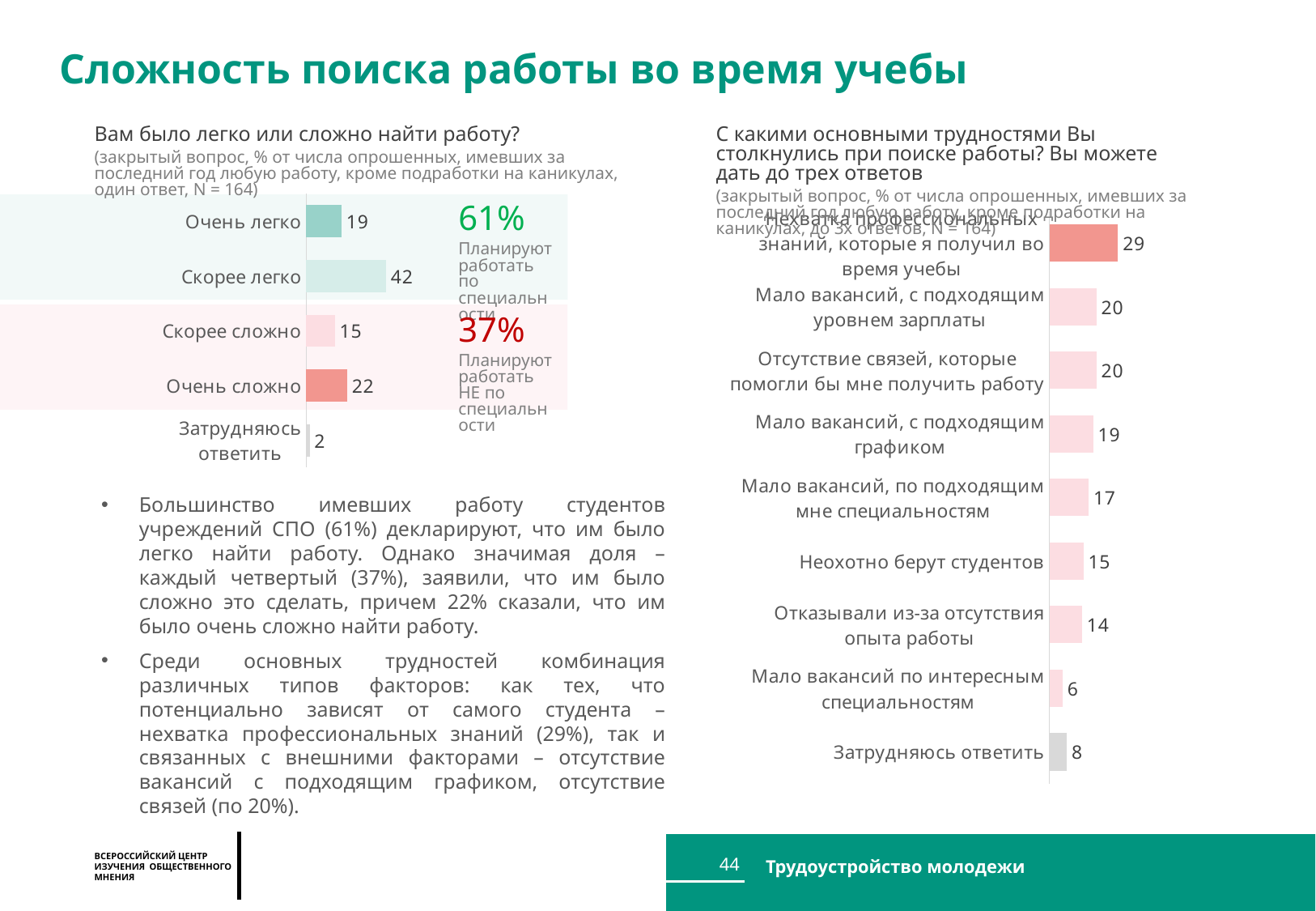
In the right chart about difficulties in finding work, which category has the lowest value? Мало вакансий по интересным специальностям In the left chart "Вам было легко или сложно найти работу?", what is the value for "Скорее легко"? 42 In the right chart about difficulties in finding work, which category has the highest value? Нехватка профессиональных знаний, которые я получил во время учебы In the left chart "Вам было легко или сложно найти работу?", which category has the lowest value? Затрудняюсь ответить In the left chart "Вам было легко или сложно найти работу?", what is the difference between "Скорее легко" and "Очень легко"? 23 In the left chart "Вам было легко или сложно найти работу?", what is the value for "Очень сложно"? 22 In the left chart "Вам было легко или сложно найти работу?", which category has the highest value? Скорее легко In the left chart "Вам было легко или сложно найти работу?", how many categories are shown? 5 What type of chart is the right chart about difficulties in finding work? Bar chart In the right chart about difficulties in finding work, what is the value for "Неохотно берут студентов"? 15 In the right chart about difficulties in finding work, what is the value for "Отказывали из-за отсутствия опыта работы"? 14 In the right chart about difficulties in finding work, which is larger: "Мало вакансий, с подходящим графиком" or "Мало вакансий, по подходящим мне специальностям"? Мало вакансий, с подходящим графиком